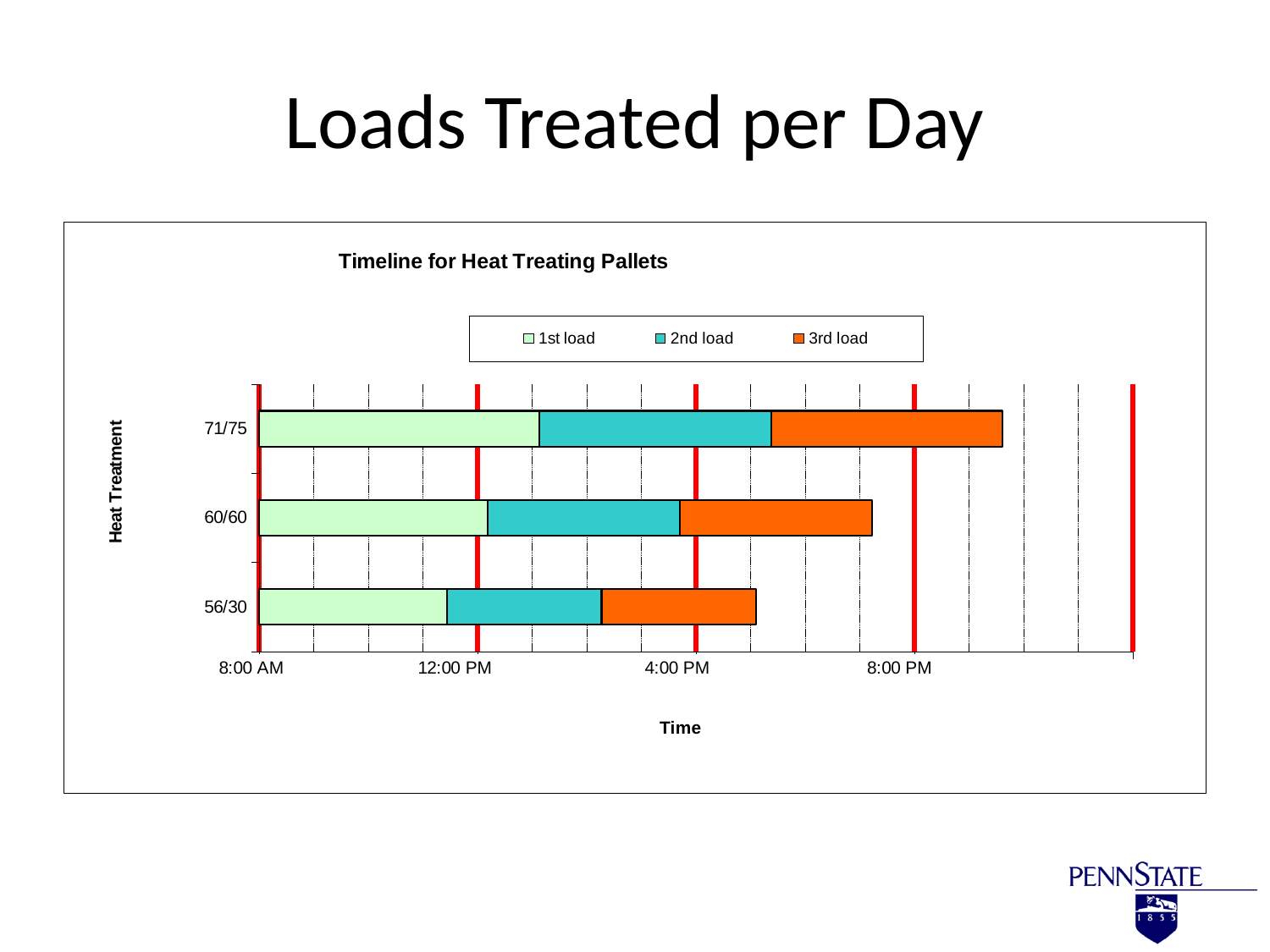
How many heat treatments are listed on the vertical axis of the chart? 3 How many series does the chart legend list? 3 What is the label of the horizontal axis? Time Which heat treatment has the shortest total bar (earliest finishing time)? 56/30 Which heat treatment has the longest total bar (latest finishing time)? 71/75 Does the 1st load for 71/75 end before or after 12:00 PM? after Does the 3rd load for 71/75 end before or after 8:00 PM? after Which heat treatment finishes its 3rd load later, 60/60 or 56/30? 60/60 Does the 3rd load for 56/30 end before or after 4:00 PM? after What kind of chart is shown on the slide? bar chart What is the title of the chart? Timeline for Heat Treating Pallets